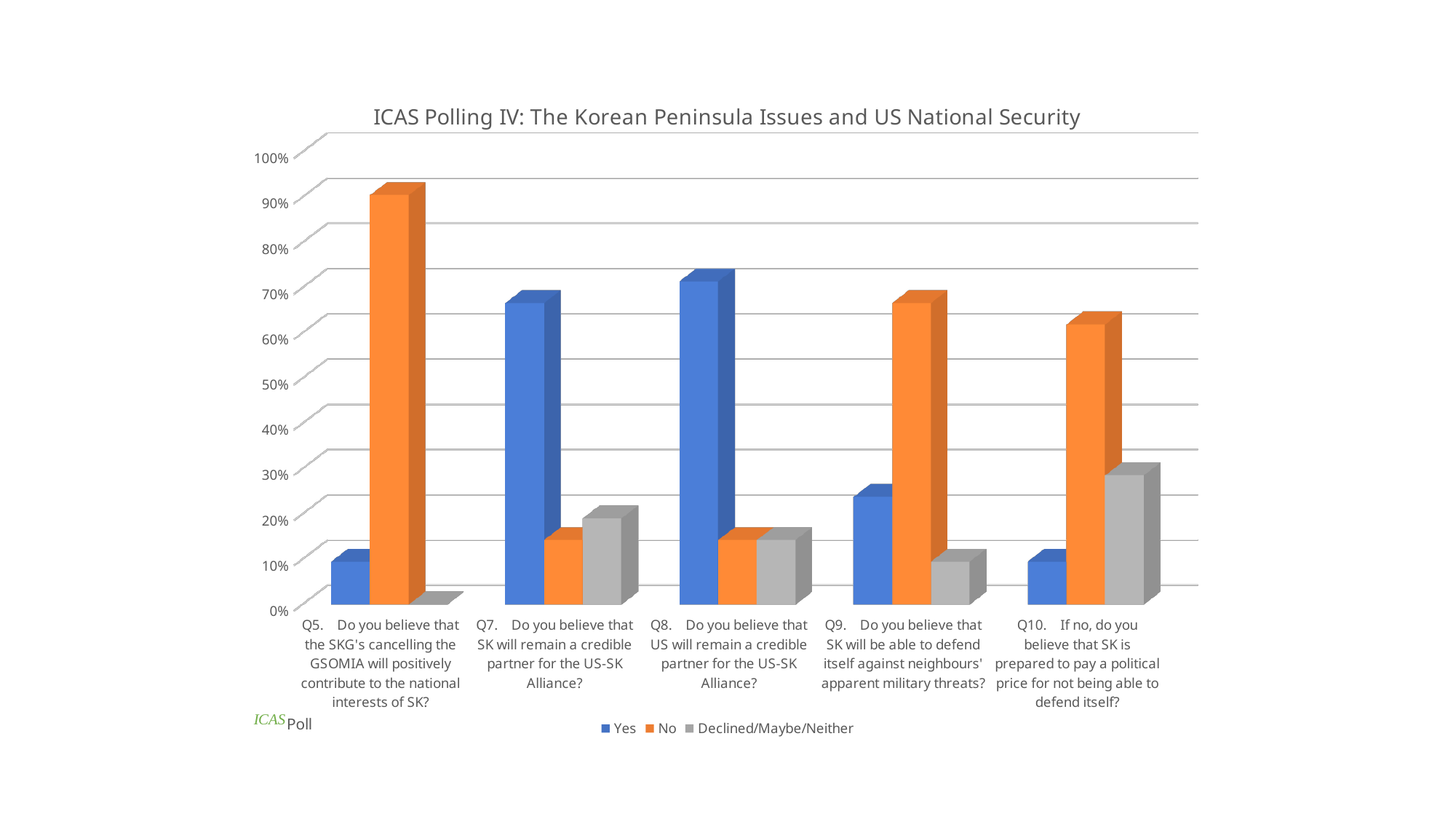
Which question has the tallest 'Yes' bar? Q8 Which is larger: the 'No' value for Q5 or for Q9? Q5 What is the title of the chart? ICAS Polling IV: The Korean Peninsula Issues and US National Security How many questions (categories) are plotted along the x axis? 5 Which is larger: the 'Declined/Maybe/Neither' value for Q10 or for Q9? Q10 Is the 'No' value for Q5 greater or less than 80%? greater Which question has the smallest 'Declined/Maybe/Neither' bar? Q5 Is the 'Declined/Maybe/Neither' value for Q10 greater or less than 20%? greater How many series does the legend list? 3 What kind of chart is shown on the slide? bar chart Which question has the tallest 'No' bar? Q5 Is the 'Yes' value for Q9 greater or less than 30%? less